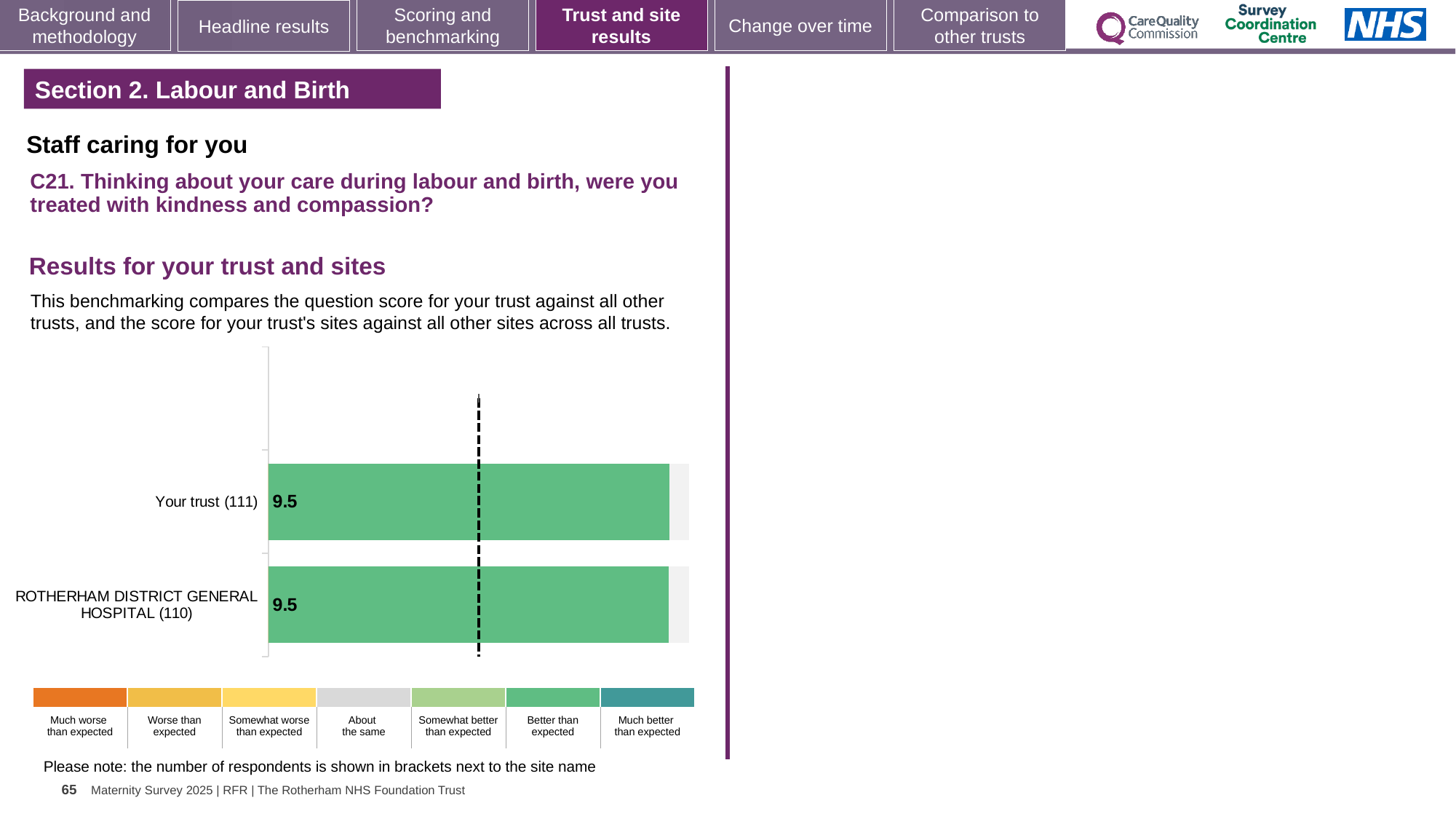
How many bars are plotted in the chart? 2 How many categories does the colour key below the chart list? 7 Which category in the colour key does the green colour of the bars correspond to? Better than expected What kind of chart is shown on the slide? Bar chart What is the score for Your trust (111)? 9.5 How many respondents are shown in brackets for Your trust? 111 What is the difference between the score for Your trust (111) and the score for ROTHERHAM DISTRICT GENERAL HOSPITAL (110)? 0 How many respondents are shown in brackets for ROTHERHAM DISTRICT GENERAL HOSPITAL? 110 Which survey question does the chart relate to? C21. Thinking about your care during labour and birth, were you treated with kindness and compassion? What is the score for ROTHERHAM DISTRICT GENERAL HOSPITAL (110)? 9.5